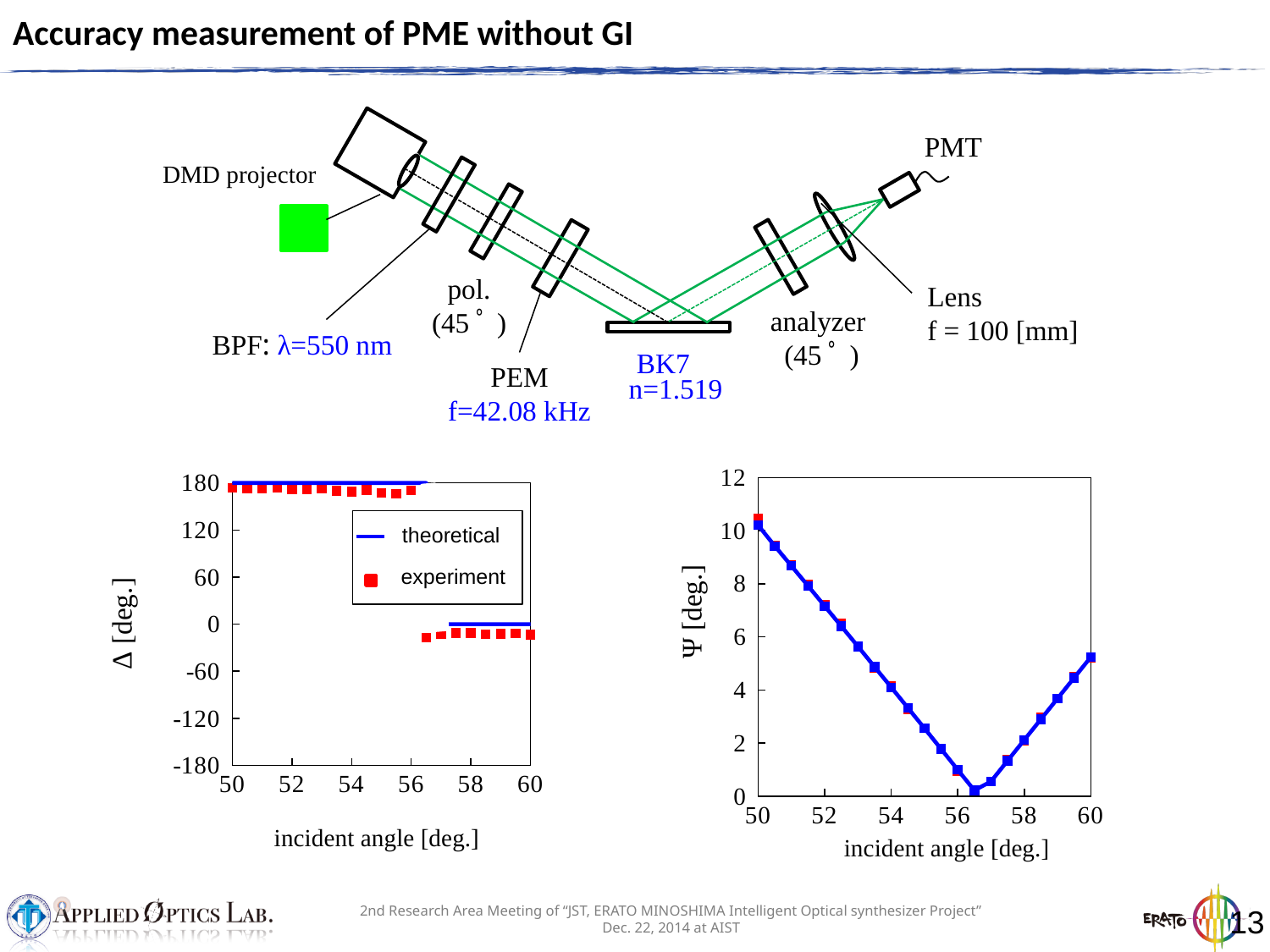
How many series does the legend on the left chart (Δ [deg.]) list? 2 On the left chart (Δ [deg.]), what are the two legend entries? theoretical, experiment On the left chart (Δ [deg.]), which is larger: the value at 52 degrees or the value at 58 degrees? 52 degrees On the right chart (Ψ [deg.]), is the value at an incident angle of 60 degrees greater or less than 4? greater What kind of chart is the left chart (Δ vs incident angle)? line chart with scatter points On the left chart (Δ [deg.]), is the value at an incident angle of 52 degrees greater or less than 120? greater On the right chart (Ψ [deg.]), is the value at an incident angle of 52 degrees greater or less than 6? greater On the left chart (Δ [deg.]), what colour are the experiment markers? red On the right chart (Ψ [deg.]), do the values rise or fall as the incident angle increases from 50 to 56 degrees? fall On the right chart (Ψ [deg.]), which is larger: the value at 50 degrees or the value at 60 degrees? 50 degrees